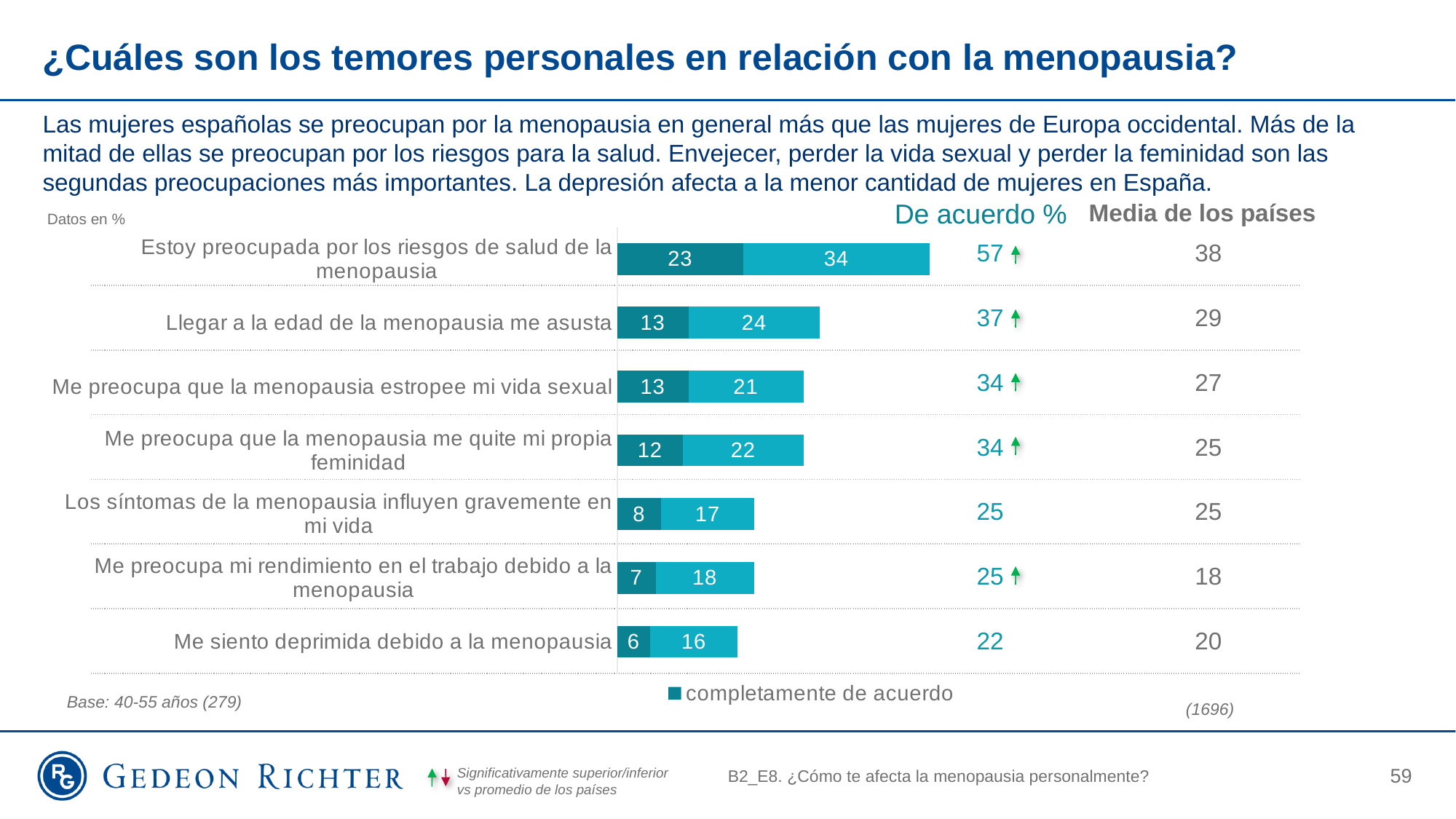
What is the 'completamente de acuerdo' value for 'Estoy preocupada por los riesgos de salud de la menopausia'? 23 What kind of chart is shown on the slide? stacked bar chart How many statements (categories) are plotted in the chart? 7 What is the total of the stacked bar for 'Los síntomas de la menopausia influyen gravemente en mi vida'? 25 What series name is shown in the chart legend? completamente de acuerdo What is the 'De acuerdo %' total for 'Me preocupa que la menopausia estropee mi vida sexual'? 34 Which is larger for 'Me siento deprimida debido a la menopausia': the 'completamente de acuerdo' segment or the lighter segment? the lighter segment (16) Which statement has the highest 'De acuerdo %' total? Estoy preocupada por los riesgos de salud de la menopausia Which statement has the lowest 'De acuerdo %' total? Me siento deprimida debido a la menopausia What is the 'Media de los países' value for 'Me preocupa mi rendimiento en el trabajo debido a la menopausia'? 18 What is the difference between the 'De acuerdo %' value and the 'Media de los países' value for 'Estoy preocupada por los riesgos de salud de la menopausia'? 19 What is the lighter-segment value for 'Llegar a la edad de la menopausia me asusta'? 24